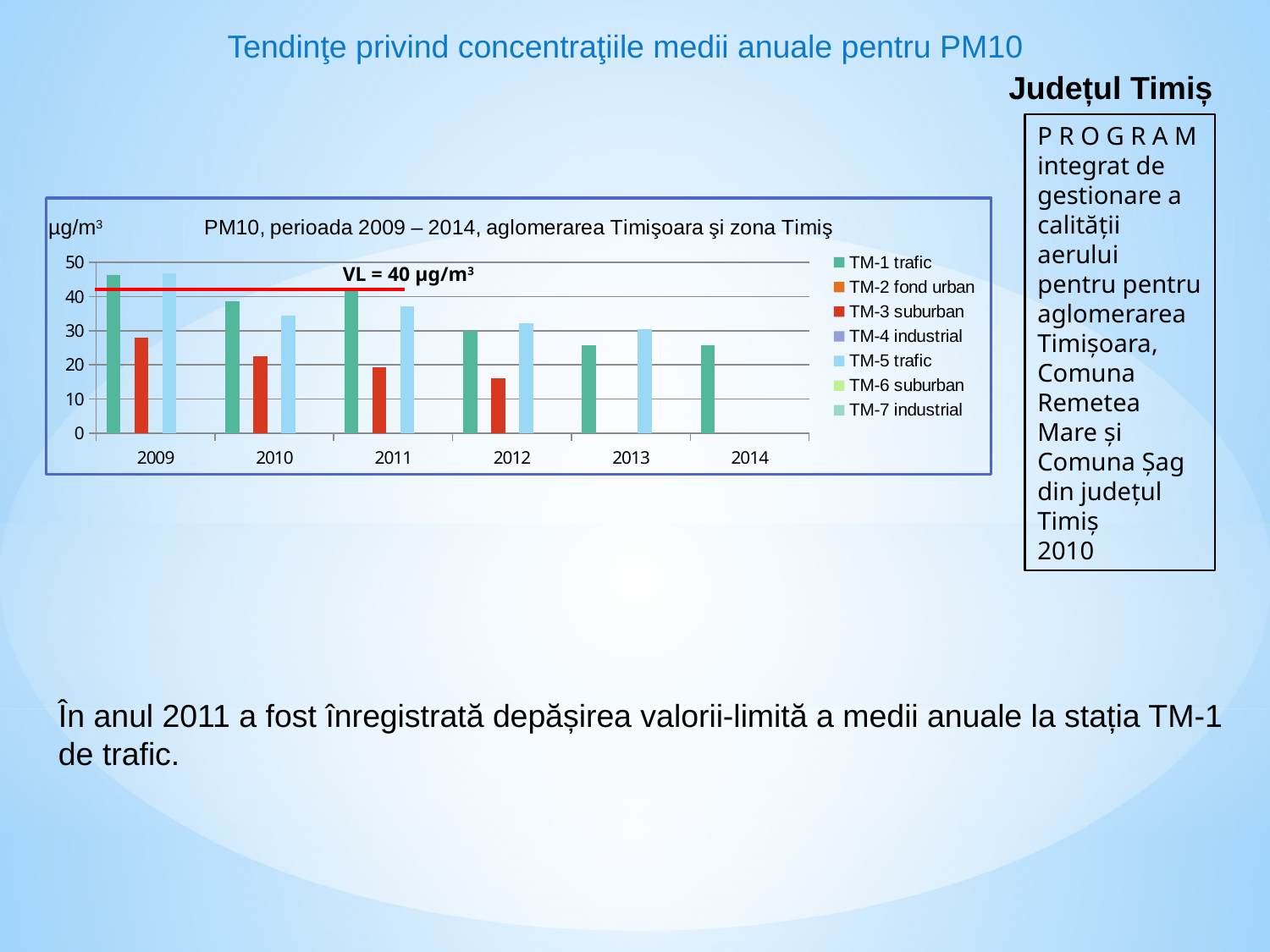
Is the value for TM-3 suburban in 2012 greater or less than 20? less Is the value for TM-1 trafic in 2013 greater or less than 30? less Is the value for TM-1 trafic in 2009 greater or less than 40? greater How many years are shown on the x axis of the chart? 6 In which year is the TM-1 trafic value highest? 2009 What is the title of the chart? PM10, perioada 2009 – 2014, aglomerarea Timişoara şi zona Timiş How many series does the chart legend list? 7 What kind of chart is shown on the slide? bar chart Do the TM-3 suburban values rise or fall from 2009 to 2012? fall What limit value (VL) is marked by the red line on the chart? VL = 40 µg/m³ In which year is the TM-3 suburban value lowest? 2012